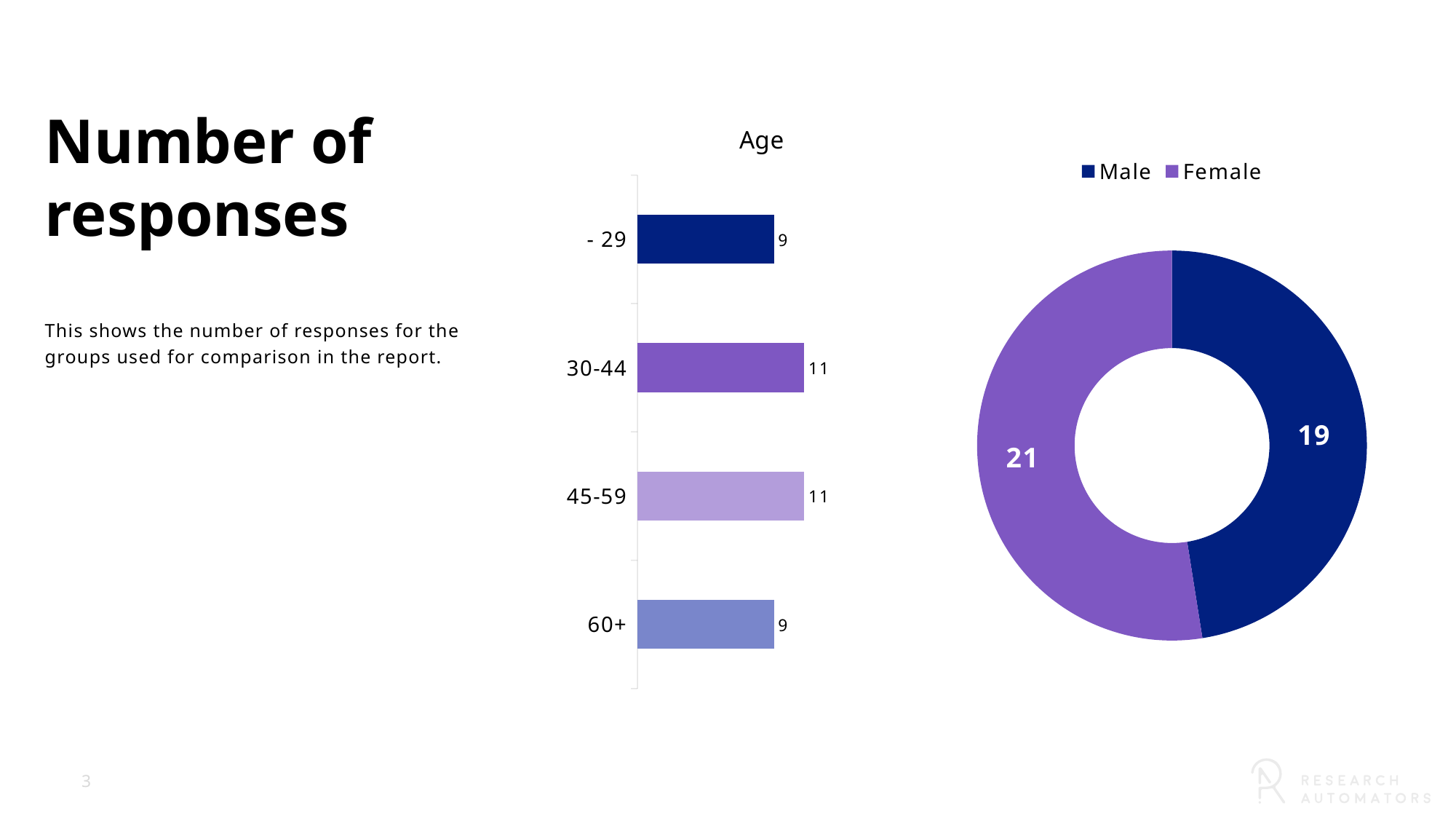
In the Male/Female chart on the right, what is the difference between Female and Male? 2 How many entries does the legend of the chart on the right list? 2 In the Age chart, how many age groups are shown? 4 In the Male/Female chart on the right, what is the value for Female? 21 In the Age chart, what is the value for the - 29 group? 9 In the Male/Female chart on the right, what is the value for Male? 19 What kind of chart is the Age chart? bar chart In the Age chart, what is the value for the 30-44 group? 11 In the Age chart, which is larger, the value for 45-59 or the value for - 29? 45-59 In the Male/Female chart on the right, which category has the highest value? Female In the Age chart, what is the value for the 60+ group? 9 In the Age chart, what is the difference between the values for 30-44 and 60+? 2